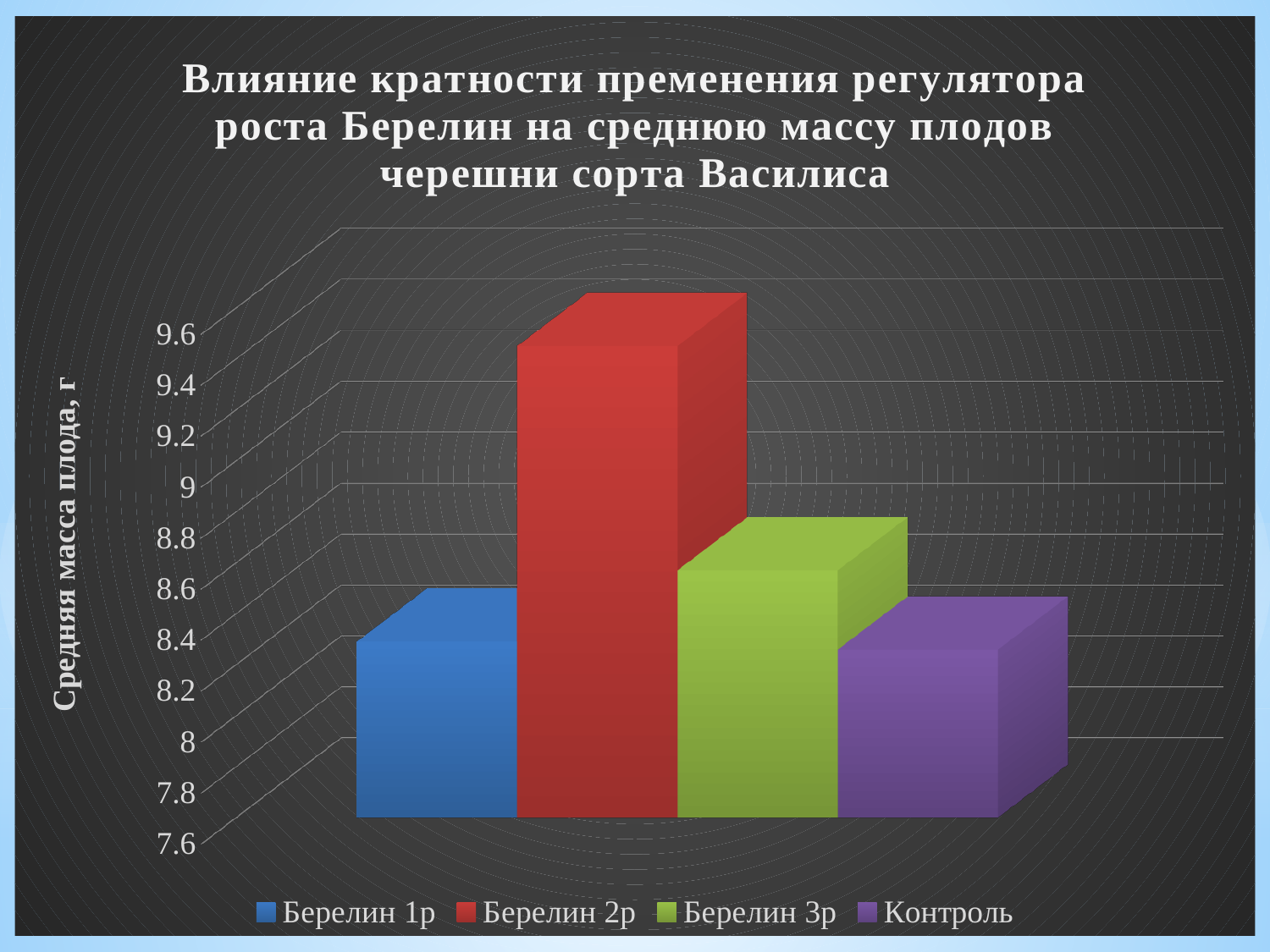
Which is larger, the value for Берелин 3р or the value for Контроль? Берелин 3р What colour is the bar for Контроль? purple What is the title of the vertical axis? Средняя масса плода, г Is the value for Берелин 2р greater or less than 9? greater Which is larger, the value for Берелин 2р or the value for Берелин 3р? Берелин 2р What kind of chart is shown on the slide? bar chart Which series has the highest average fruit mass? Берелин 2р Is the value for Контроль greater or less than 9? less How many bars are plotted in the chart? 4 Is the value for Берелин 1р greater or less than 8.8? less How many series does the legend list? 4